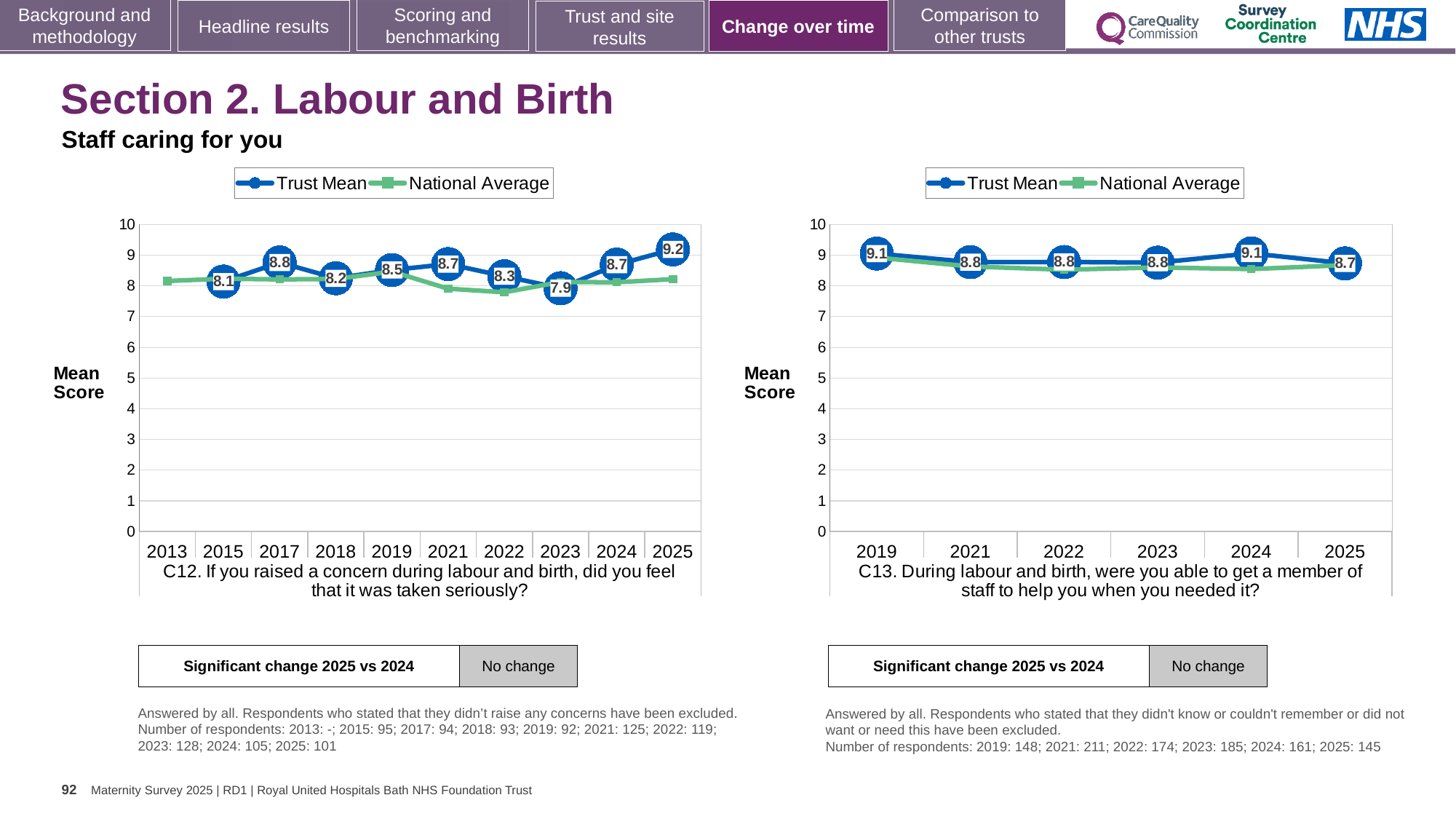
In the C12 chart on the left, what is the difference between the Trust Mean for 2025 and for 2024? 0.5 In the C12 chart on the left, what is the Trust Mean for 2025? 9.2 In the C13 chart on the right, what is the Trust Mean for 2021? 8.8 In the C12 chart on the left, which year has the highest Trust Mean? 2025 In the C13 chart on the right, how many series does the legend list? 2 In the C13 chart on the right, what is the Trust Mean for 2025? 8.7 In the C12 chart on the left, what is the Trust Mean for 2023? 7.9 In the C13 chart on the right, is the National Average for 2019 greater or less than 7? greater In the C12 chart on the left, how many years are shown on the x axis? 10 In the C13 chart on the right, is the Trust Mean for 2019 larger or smaller than the Trust Mean for 2025? larger In the C12 chart on the left, which year has the lowest Trust Mean? 2023 What kind of chart is the C12 chart on the left? line chart